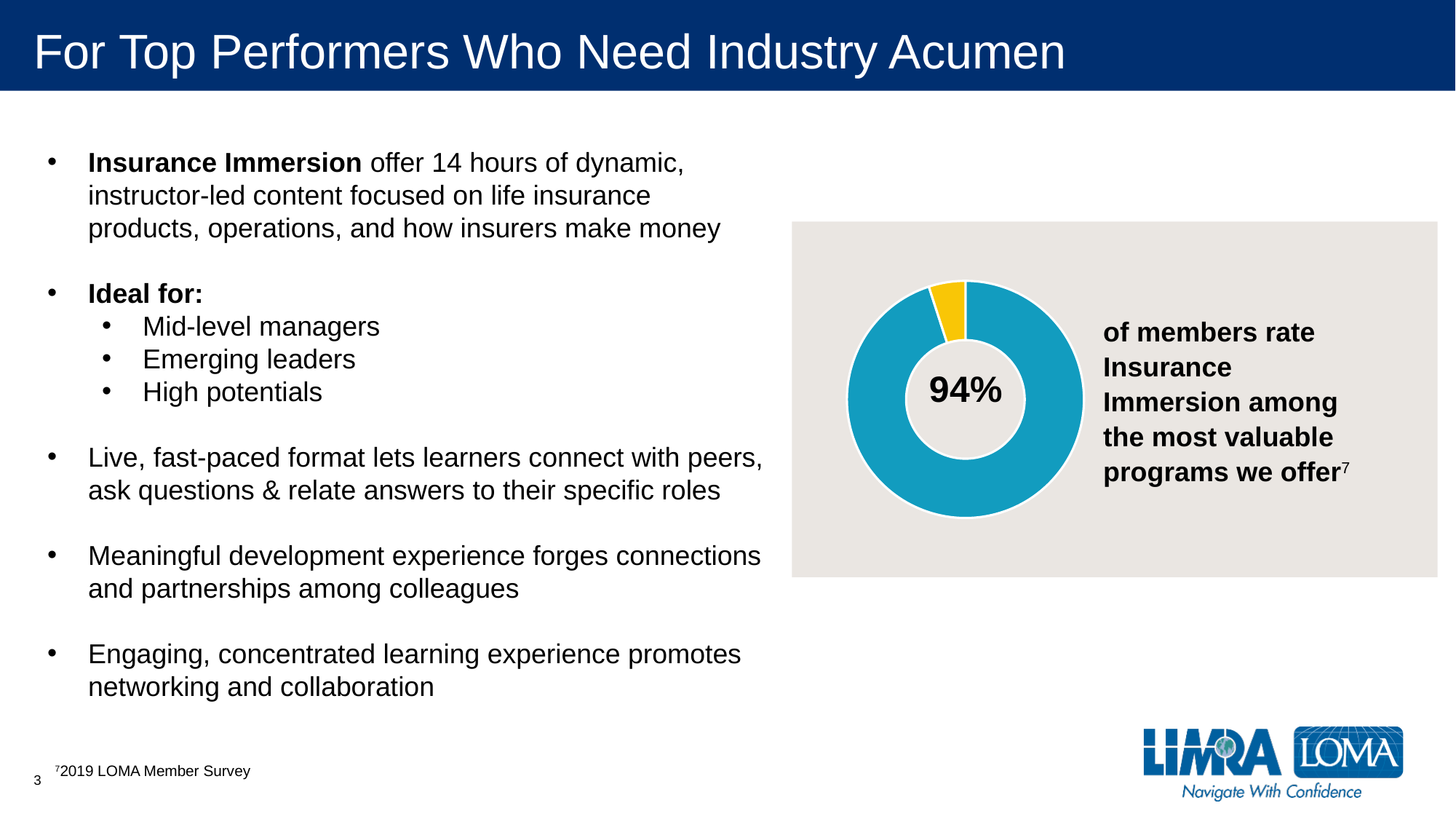
What kind of chart is shown on the right side of the slide? Donut (pie) chart What is the source cited for the donut chart's 94% figure? 2019 LOMA Member Survey What percentage is printed in the centre of the donut chart? 94% Which slice of the donut chart is larger, the blue one or the yellow one? The blue one Is the share shown by the yellow slice of the donut chart greater or less than 25%? less What colour is the smallest slice of the donut chart? Yellow Is the share shown by the blue slice of the donut chart greater or less than 50%? greater How many slices does the donut chart have? 2 What colour is the largest slice of the donut chart? Blue According to the donut chart, what share of members rate Insurance Immersion among the most valuable programs offered? 94%